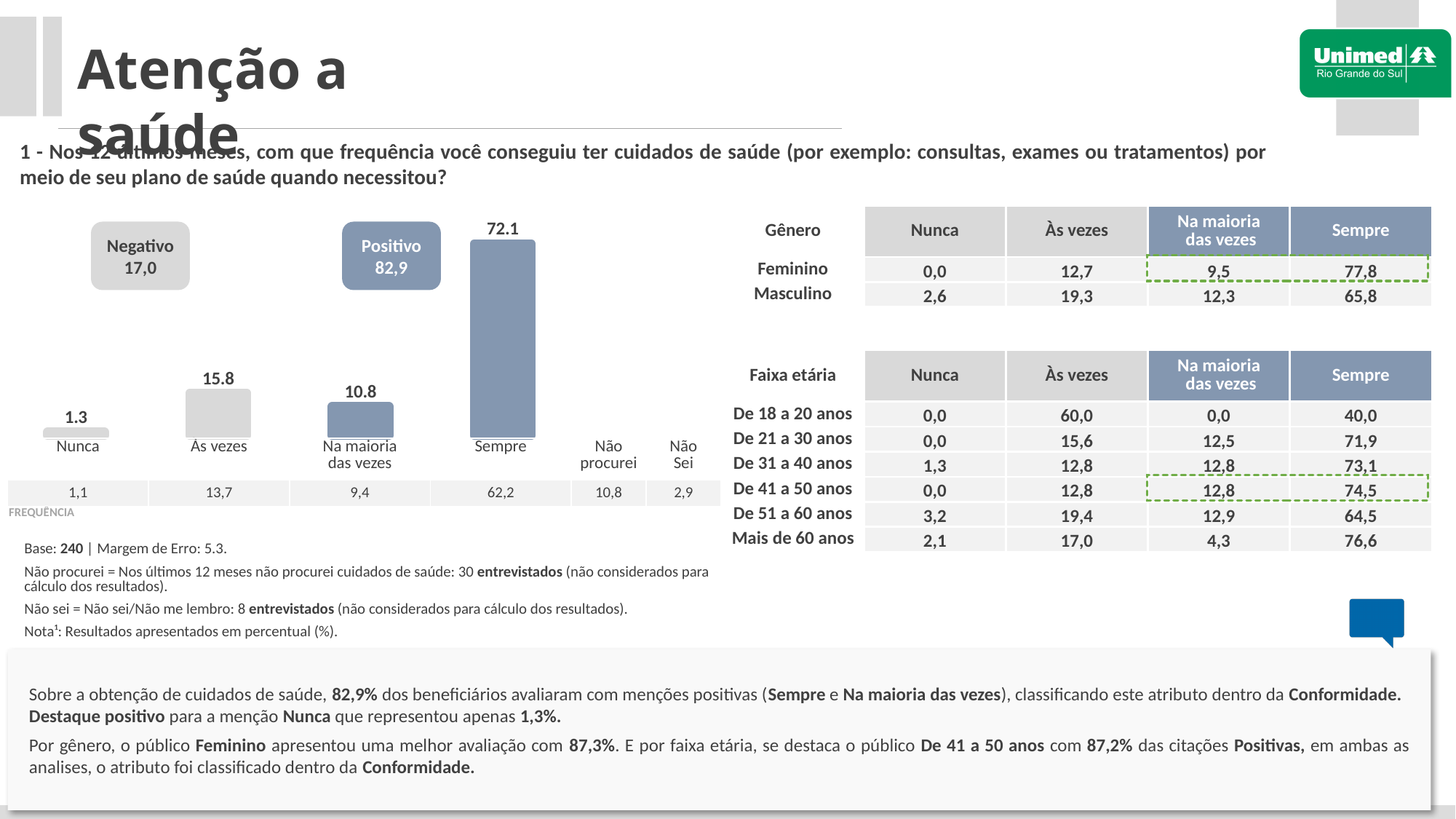
What value is shown in the "Positivo" box above the bar chart? 82,9 Which is larger in the bar chart, the value for "Às vezes" or the value for "Na maioria das vezes"? Às vezes What is the difference between the values for "Sempre" and "Às vezes" in the bar chart? 56.3 What is the value shown for "Na maioria das vezes" in the bar chart? 10.8 What is the value shown for "Às vezes" in the bar chart? 15.8 What type of chart is used to show the frequency responses? Bar chart What is the difference between the values for "Às vezes" and "Na maioria das vezes" in the bar chart? 5.0 What is the value shown for "Sempre" in the bar chart? 72.1 What is the value shown for "Nunca" in the bar chart? 1.3 Which category has the lowest bar in the chart? Nunca How many bars with data labels are plotted in the bar chart? 4 Which category has the highest bar in the chart? Sempre